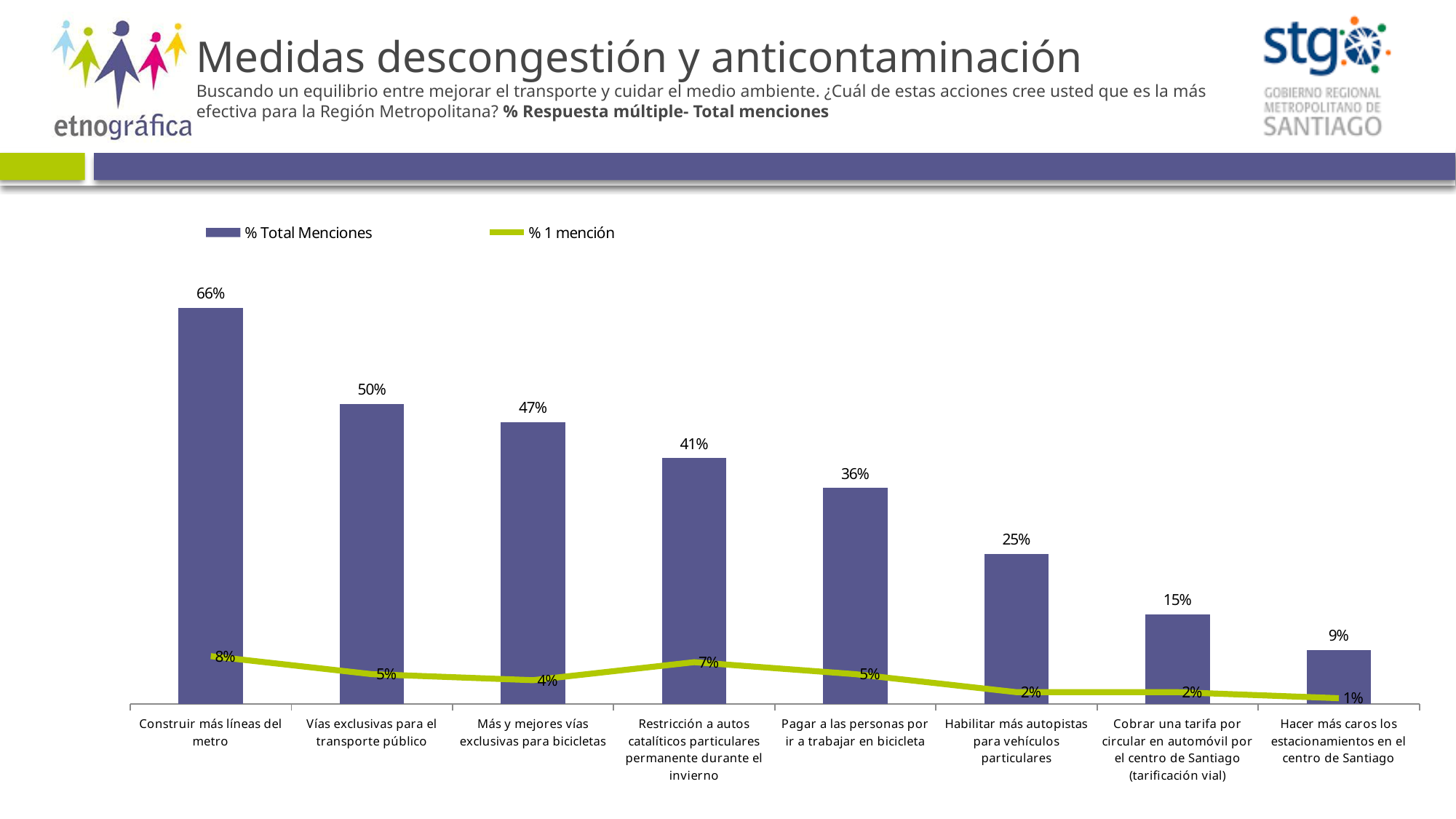
What colour is the % 1 mención line? Green Which has a higher % Total Menciones: "Pagar a las personas por ir a trabajar en bicicleta" or "Habilitar más autopistas para vehículos particulares"? Pagar a las personas por ir a trabajar en bicicleta Do the % Total Menciones values rise or fall from left to right along the x axis? Fall What is the % 1 mención value for "Restricción a autos catalíticos particulares permanente durante el invierno"? 7% Which category has the highest % Total Menciones? Construir más líneas del metro Which category has the lowest % 1 mención? Hacer más caros los estacionamientos en el centro de Santiago How many categories are shown on the x axis? 8 What is the difference in % Total Menciones between "Vías exclusivas para el transporte público" and "Más y mejores vías exclusivas para bicicletas"? 3% What is the % Total Menciones value for "Cobrar una tarifa por circular en automóvil por el centro de Santiago (tarificación vial)"? 15% What is the % Total Menciones value for "Construir más líneas del metro"? 66% How many series does the legend list? 2 What kind of chart is used for the % Total Menciones series? Bar chart